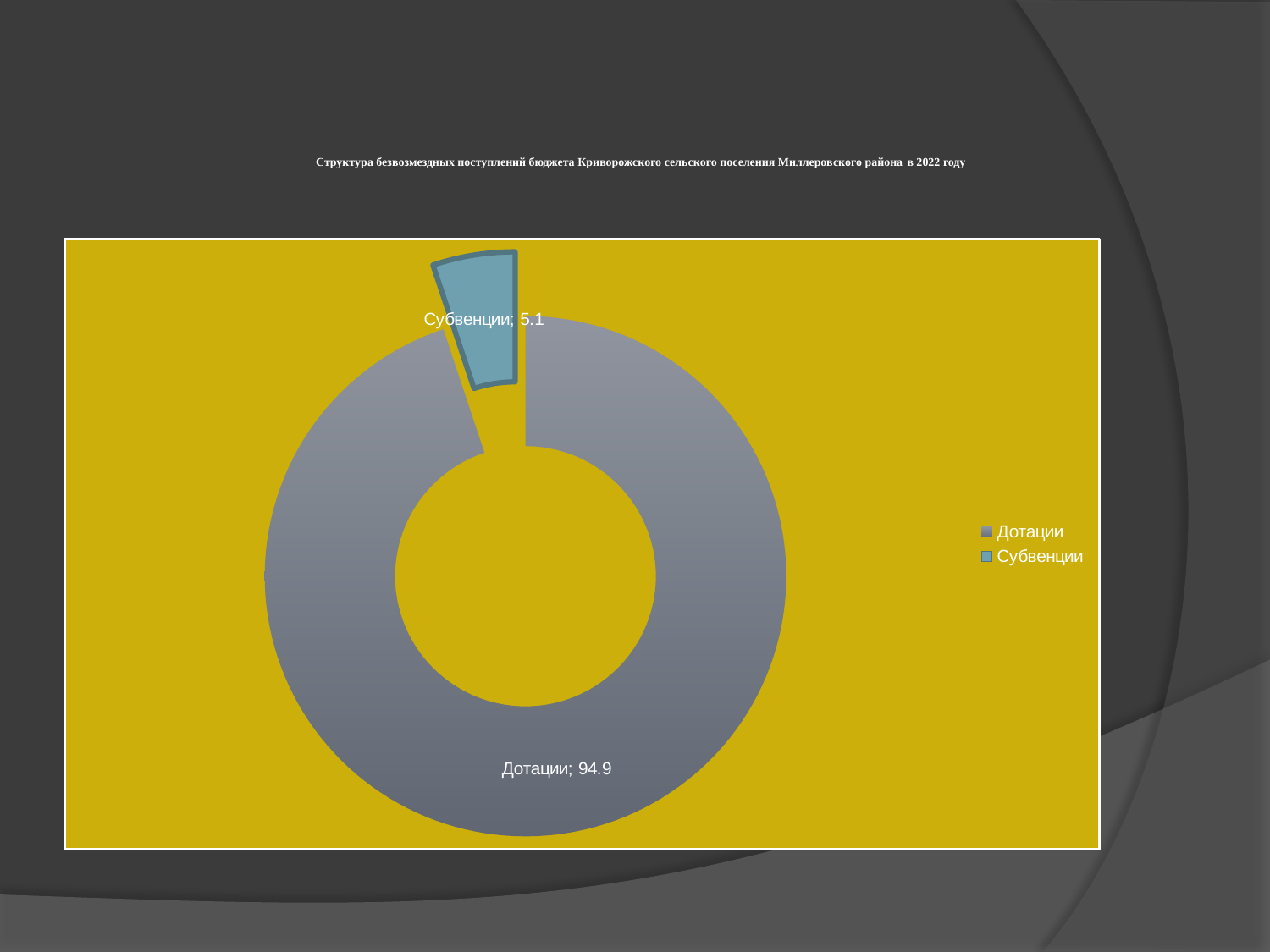
How many categories are shown in the chart? 2 What is the value shown for Субвенции? 5.1 What is the value shown for Дотации? 94.9 Which category has the largest share of the chart? Дотации What is the difference between the values for Дотации and Субвенции? 89.8 Which category has the smallest share of the chart? Субвенции What is the total of the two values shown in the chart? 100 Which is larger, the value for Дотации or the value for Субвенции? Дотации Which legend entry is shown in blue? Субвенции Which year does the chart title refer to? 2022 What kind of chart is shown on the slide? Doughnut chart How many entries does the legend list? 2